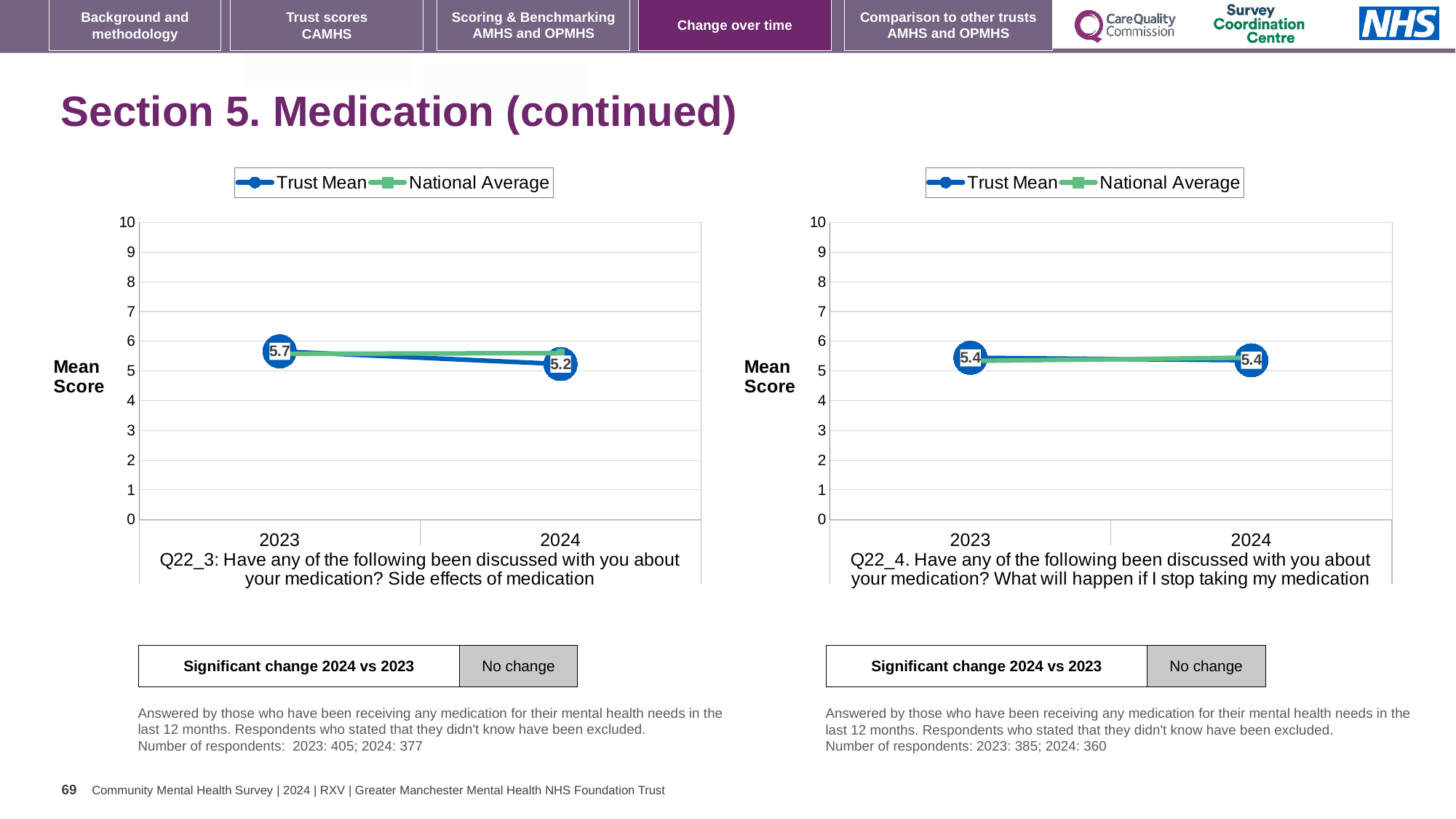
What kind of chart is the left chart (Q22_3)? line chart In the left chart (Q22_3), what is the Trust Mean for 2023? 5.7 In the left chart (Q22_3), is the National Average for 2024 greater or less than 5? greater In the left chart (Q22_3), what is the Trust Mean for 2024? 5.2 In the right chart (Q22_4), does the Trust Mean rise, fall or stay the same from 2023 to 2024? stay the same In the left chart (Q22_3), by how much did the Trust Mean change from 2023 to 2024? decreased by 0.5 How many years are plotted on the x axis of the left chart (Q22_3)? 2 In the right chart (Q22_4), what is the Trust Mean for 2024? 5.4 In the left chart (Q22_3), which year has the higher Trust Mean, 2023 or 2024? 2023 In the left chart (Q22_3), does the Trust Mean rise or fall from 2023 to 2024? fall What is the maximum value shown on the y axis of the right chart (Q22_4)? 10 How many series does the legend of the right chart (Q22_4) list? 2